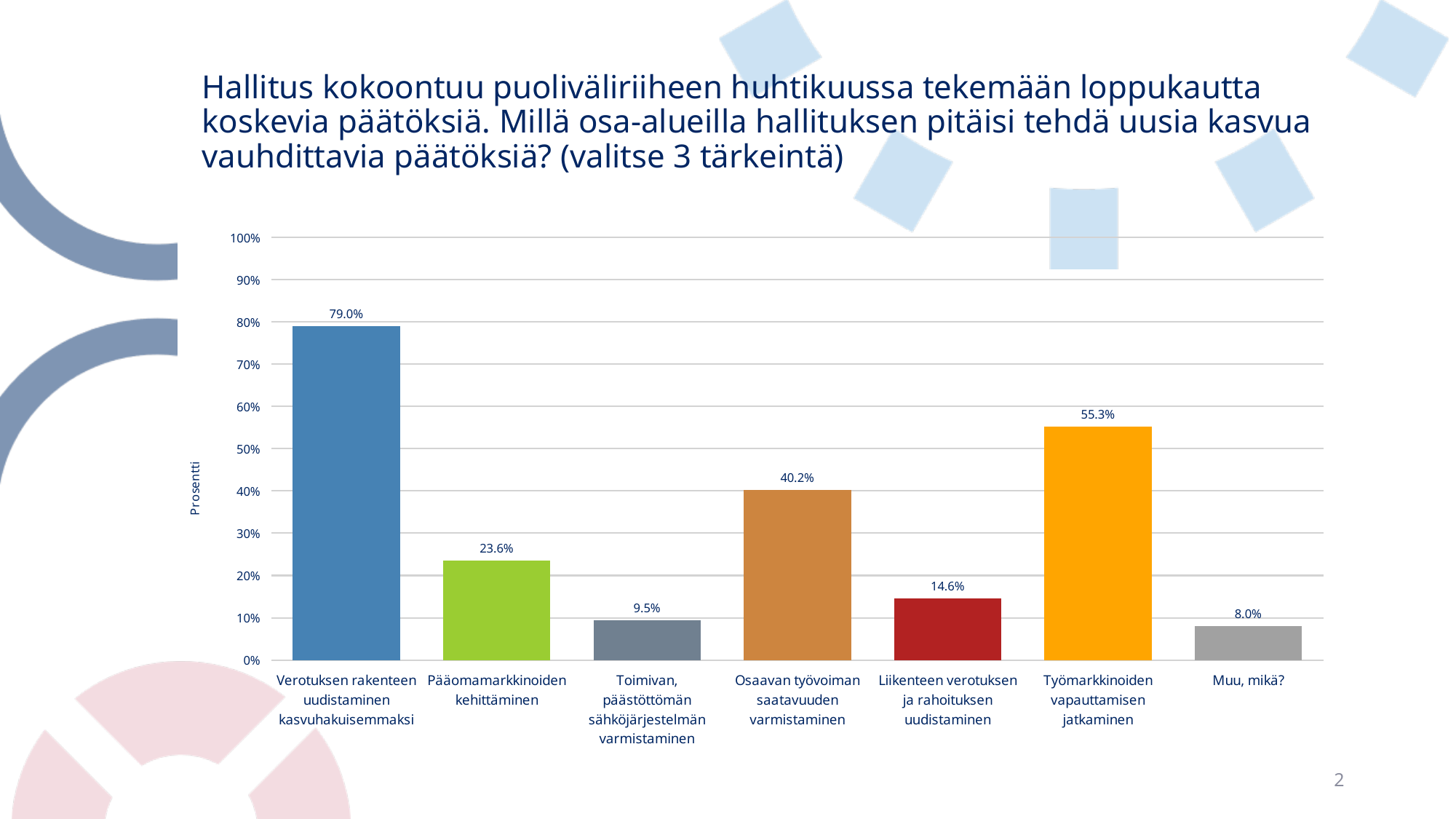
Is the value for "Toimivan, päästöttömän sähköjärjestelmän varmistaminen" greater or less than 10%? less What is the difference between the values for "Verotuksen rakenteen uudistaminen kasvuhakuisemmaksi" and "Työmarkkinoiden vapauttamisen jatkaminen"? 23.7% What is the value for "Työmarkkinoiden vapauttamisen jatkaminen"? 55.3% Which category has the lowest value? Muu, mikä? What kind of chart is shown on the slide? bar chart What is the value for "Osaavan työvoiman saatavuuden varmistaminen"? 40.2% Which is larger: the value for "Pääomamarkkinoiden kehittäminen" or the value for "Liikenteen verotuksen ja rahoituksen uudistaminen"? Pääomamarkkinoiden kehittäminen Which category has the highest value? Verotuksen rakenteen uudistaminen kasvuhakuisemmaksi What is the label of the vertical axis? Prosentti How many categories are shown on the x axis? 7 What is the value for "Verotuksen rakenteen uudistaminen kasvuhakuisemmaksi"? 79.0% What is the value for "Muu, mikä?"? 8.0%